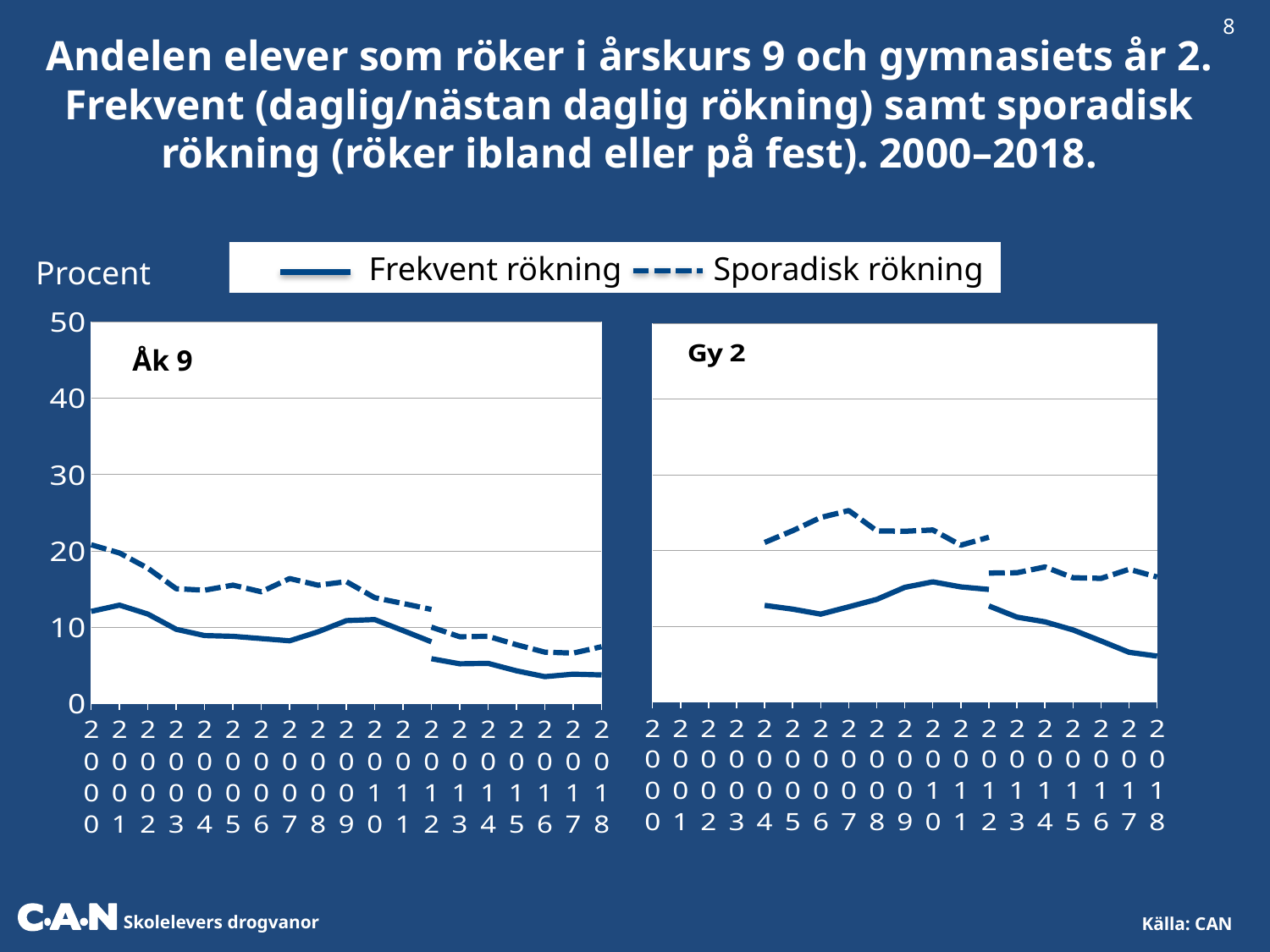
In the Gy 2 chart, is the value for Frekvent rökning in 2018 greater or less than 10? less How many series does the legend list? 2 Which series is drawn with a dashed line in the legend? Sporadisk rökning In the Gy 2 chart, is the value for Sporadisk rökning in 2007 greater or less than 20? greater In the Åk 9 chart, is the value for Frekvent rökning in 2018 greater or less than 10? less What kind of chart is the Åk 9 chart? line chart In the Gy 2 chart, does Frekvent rökning have a higher value in 2010 or in 2018? 2010 In the Åk 9 chart, does Frekvent rökning overall rise or fall from 2000 to 2018? fall In the Åk 9 chart, which series has the higher value in 2000, Frekvent rökning or Sporadisk rökning? Sporadisk rökning What is the label shown above the y axis? Procent